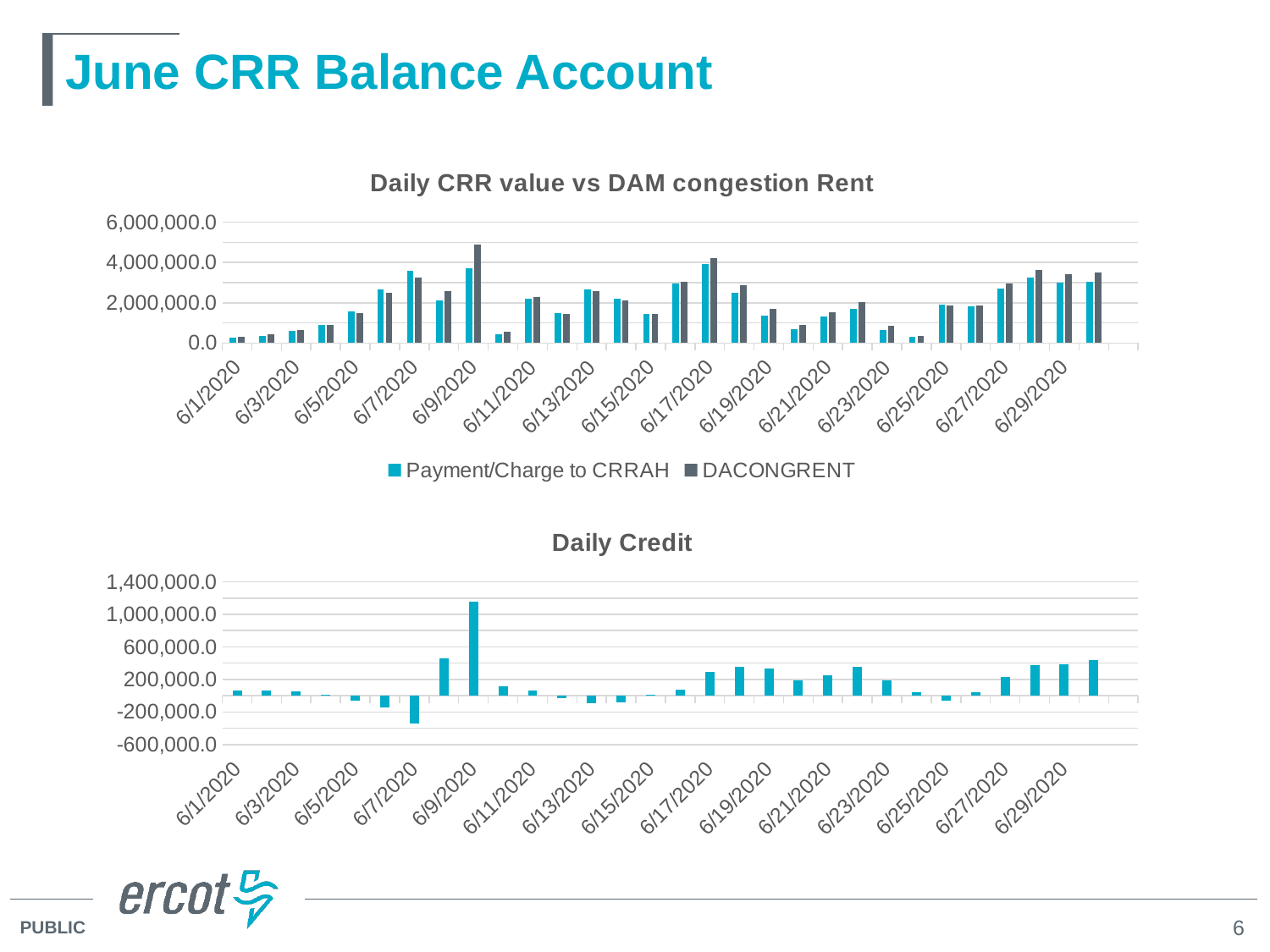
In the 'Daily CRR value vs DAM congestion Rent' chart, on 6/9/2020, which is larger: Payment/Charge to CRRAH or DACONGRENT? DACONGRENT In the 'Daily Credit' chart, is the value for 6/9/2020 greater or less than 1,000,000.0? greater How many series does the legend of the 'Daily CRR value vs DAM congestion Rent' chart list? 2 In the 'Daily CRR value vs DAM congestion Rent' chart, on which date is the DACONGRENT bar highest? 6/9/2020 In the 'Daily Credit' chart, on which date is the value highest? 6/9/2020 What kind of chart is the 'Daily Credit' chart? bar chart What kind of chart is the 'Daily CRR value vs DAM congestion Rent' chart? bar chart In the 'Daily CRR value vs DAM congestion Rent' chart, what are the two series named in the legend? Payment/Charge to CRRAH and DACONGRENT In the 'Daily CRR value vs DAM congestion Rent' chart, is the DACONGRENT value for 6/9/2020 greater or less than 4,000,000.0? greater In the 'Daily CRR value vs DAM congestion Rent' chart, is the Payment/Charge to CRRAH value for 6/1/2020 greater or less than 2,000,000.0? less In the 'Daily Credit' chart, on which date is the value lowest? 6/7/2020